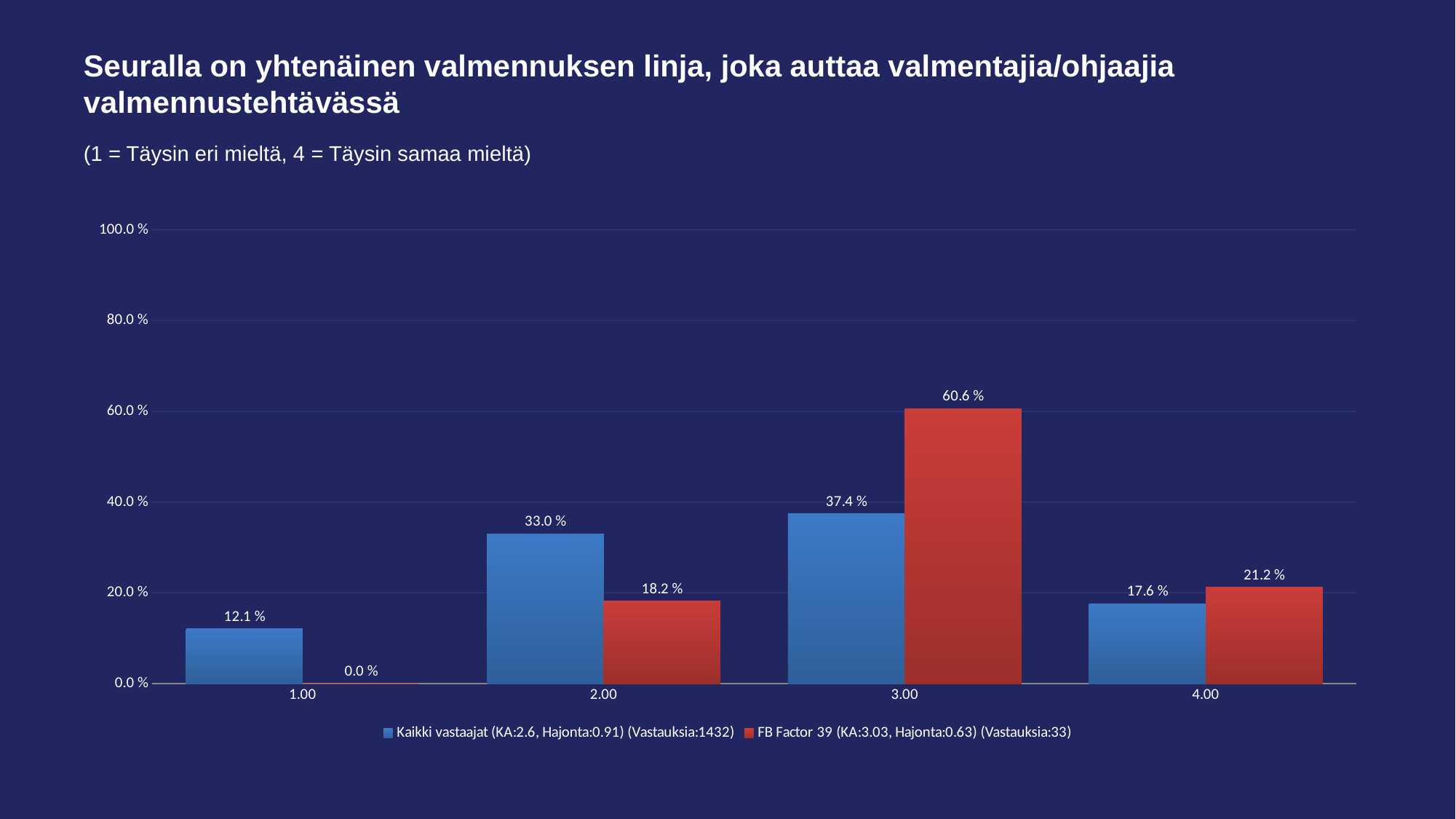
What kind of chart is shown on the slide? Bar chart What is the difference between the FB Factor 39 and Kaikki vastaajat values at category 3.00? 23.2 % Which category has the lowest value for Kaikki vastaajat? 1.00 Is the value for FB Factor 39 at category 3.00 greater or less than 40.0 %? greater How many series does the legend list? 2 At category 2.00, which series has the larger value, Kaikki vastaajat or FB Factor 39? Kaikki vastaajat What is the value for FB Factor 39 at category 1.00? 0.0 % How many categories are shown on the x axis? 4 What colour are the bars for the FB Factor 39 series? Red What is the value for Kaikki vastaajat at category 3.00? 37.4 % What is the value for FB Factor 39 at category 4.00? 21.2 % Which category has the highest value for FB Factor 39? 3.00